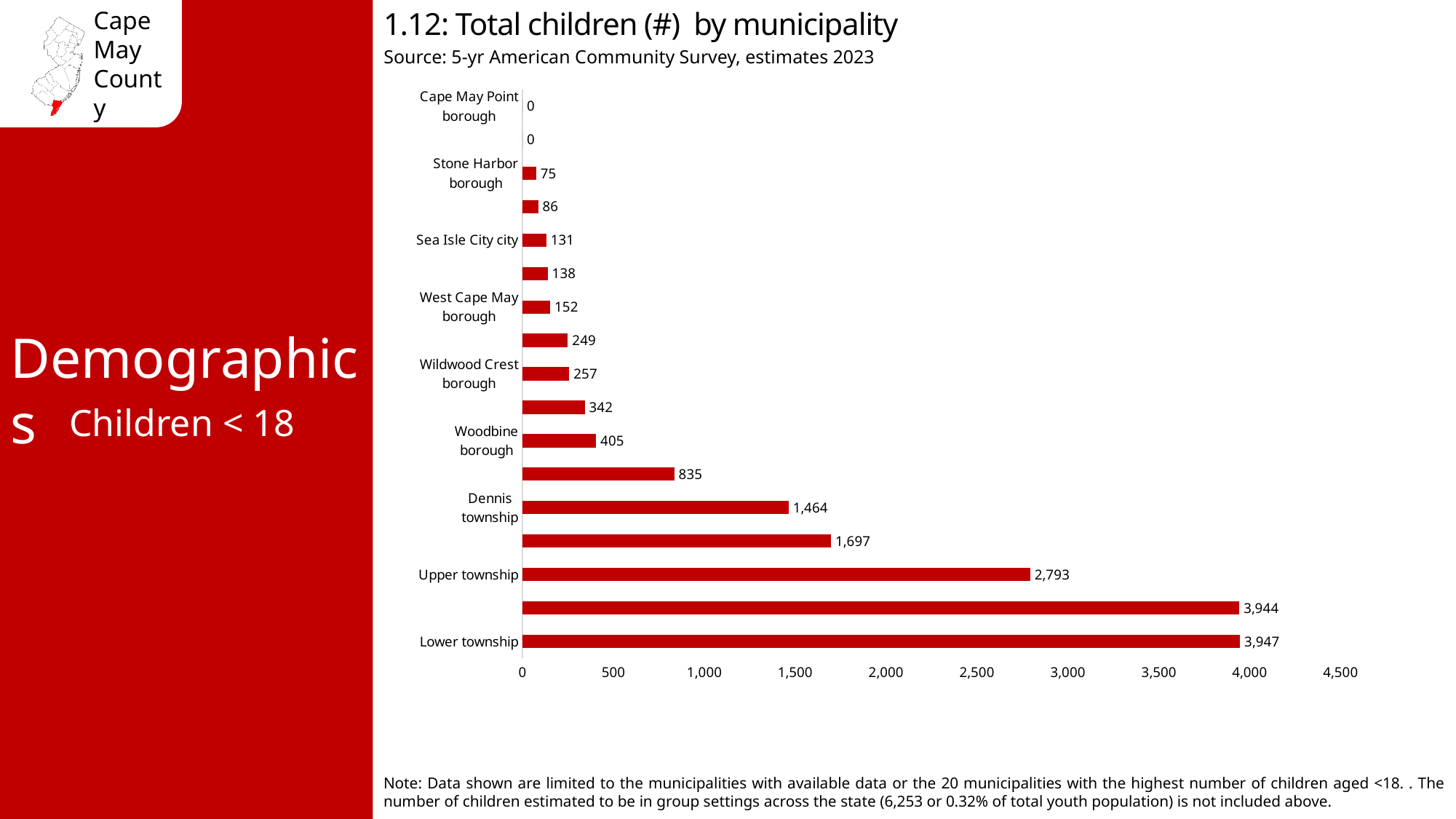
What is the total number of children for Lower township? 3,947 What is the total number of children for Upper township? 2,793 What is the lowest value shown on the chart? 0 What is the difference in total children between Wildwood Crest borough and West Cape May borough? 105 What is the total number of children for Woodbine borough? 405 Which has more children, Sea Isle City city or Woodbine borough? Woodbine borough What is the total number of children for Stone Harbor borough? 75 Is the value for Upper township greater or less than 2,500? greater Which municipality has the highest number of children? Lower township What kind of chart is shown on the slide? Bar chart What is the difference in total children between Lower township and Upper township? 1,154 What is the total number of children for Dennis township? 1,464